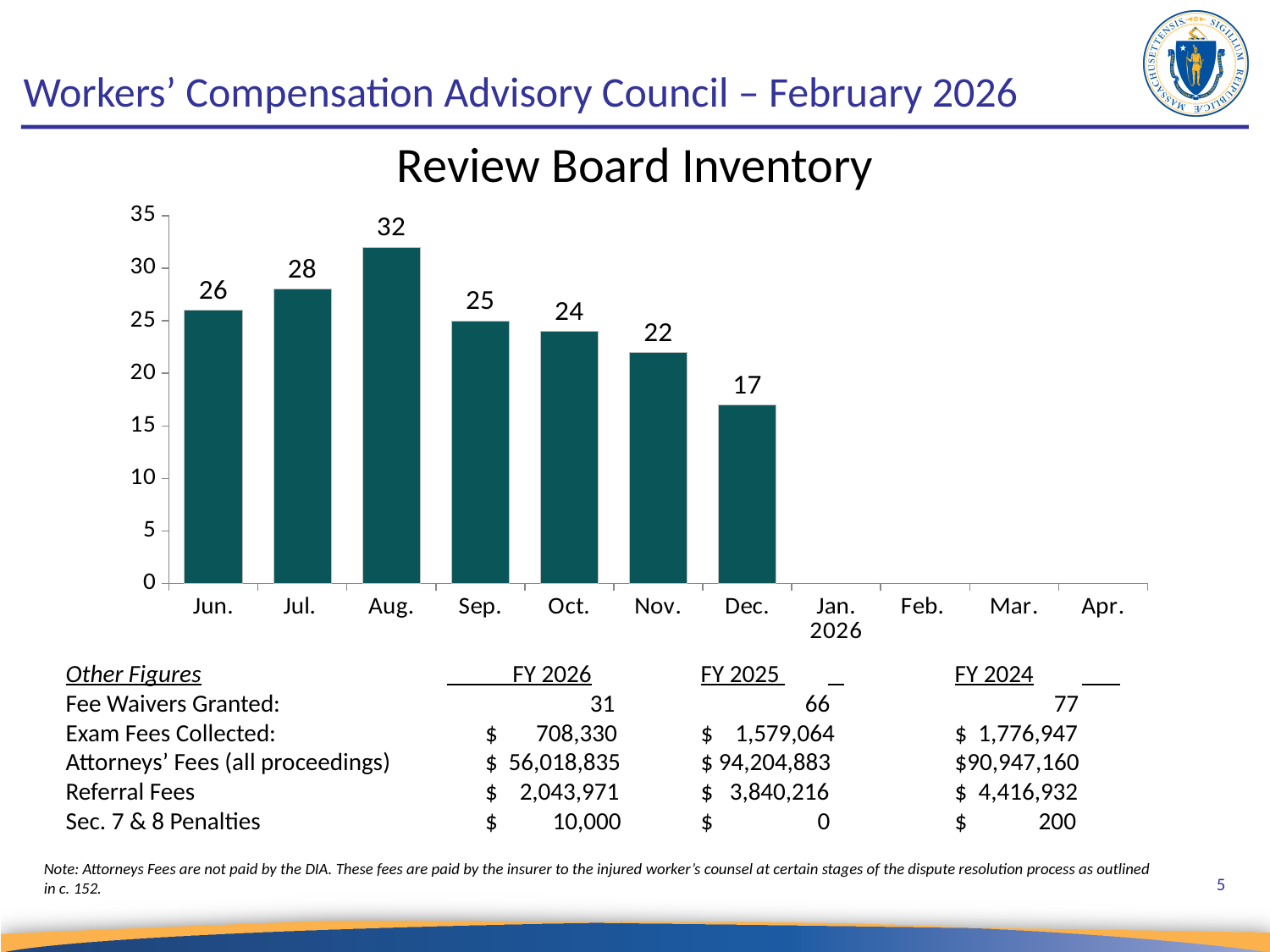
What kind of chart is the Review Board Inventory chart? bar chart What is the Review Board Inventory value for Aug.? 32 From Aug. to Dec., does the Review Board Inventory rise or fall? fall Which month has the highest Review Board Inventory? Aug. Which month with a plotted bar has the lowest Review Board Inventory? Dec. Which is larger, the Review Board Inventory for Oct. or Nov.? Oct. What is the Review Board Inventory value for Dec.? 17 Is the Review Board Inventory value for Nov. greater or less than 20? greater How many months have a plotted bar in the Review Board Inventory chart? 7 What is the Review Board Inventory value for Jun.? 26 What is the difference between the Review Board Inventory for Aug. and Dec.? 15 What is the difference between the Review Board Inventory for Jul. and Sep.? 3